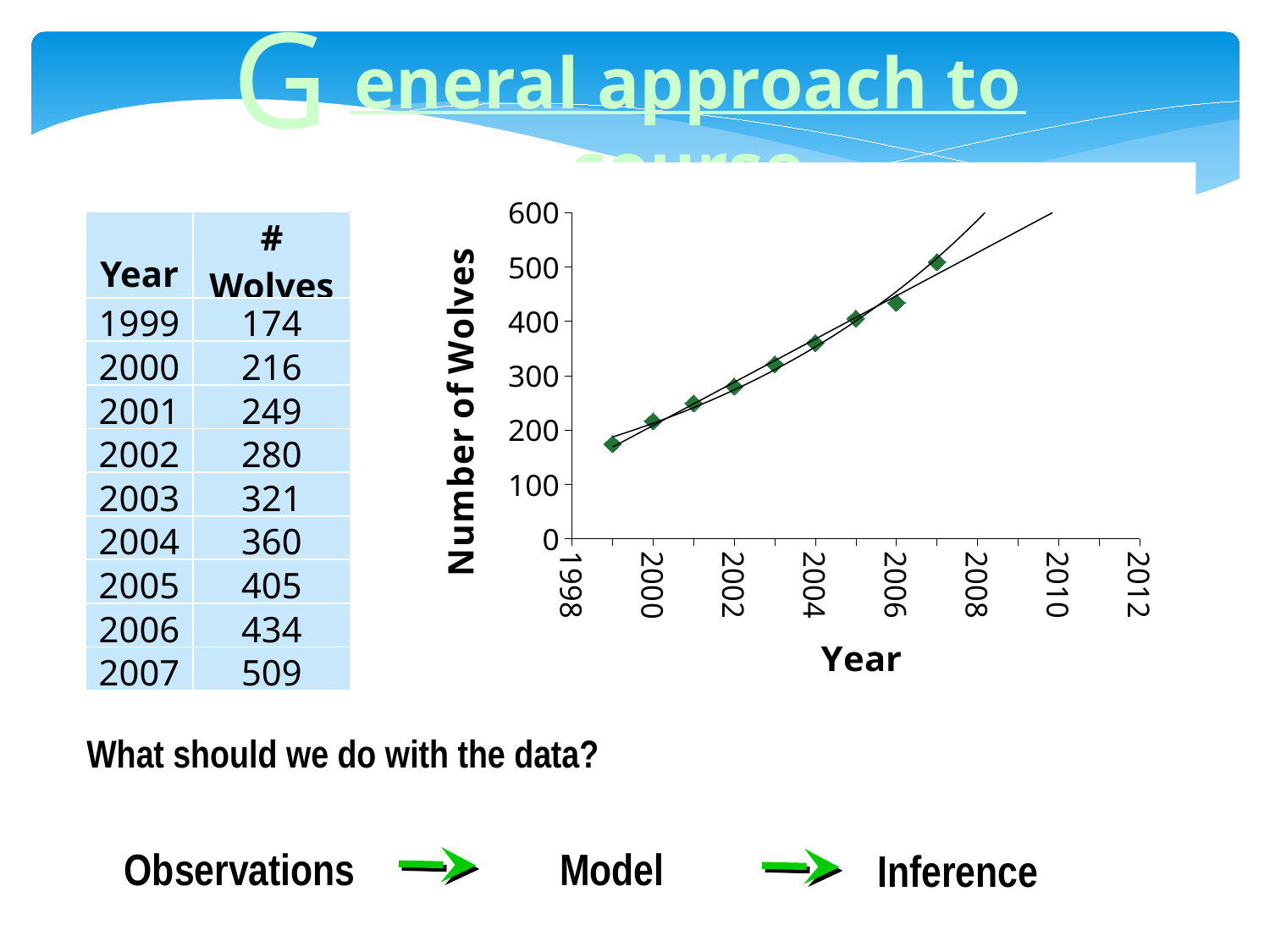
What is the difference between the number of wolves in 2007 and in 1999? 335 What is the number of wolves for 2007? 509 Do the plotted values rise or fall as the year increases? rise Which year has the lowest number of wolves? 1999 Is the value for 2006 greater or less than 400? greater What is the title of the vertical axis? Number of Wolves What kind of chart is shown on the slide? scatter chart What is the number of wolves for 1999? 174 Which year has more wolves, 2003 or 2004? 2004 What is the title of the horizontal axis? Year How many data points are plotted on the chart? 9 Which year has the highest number of wolves? 2007